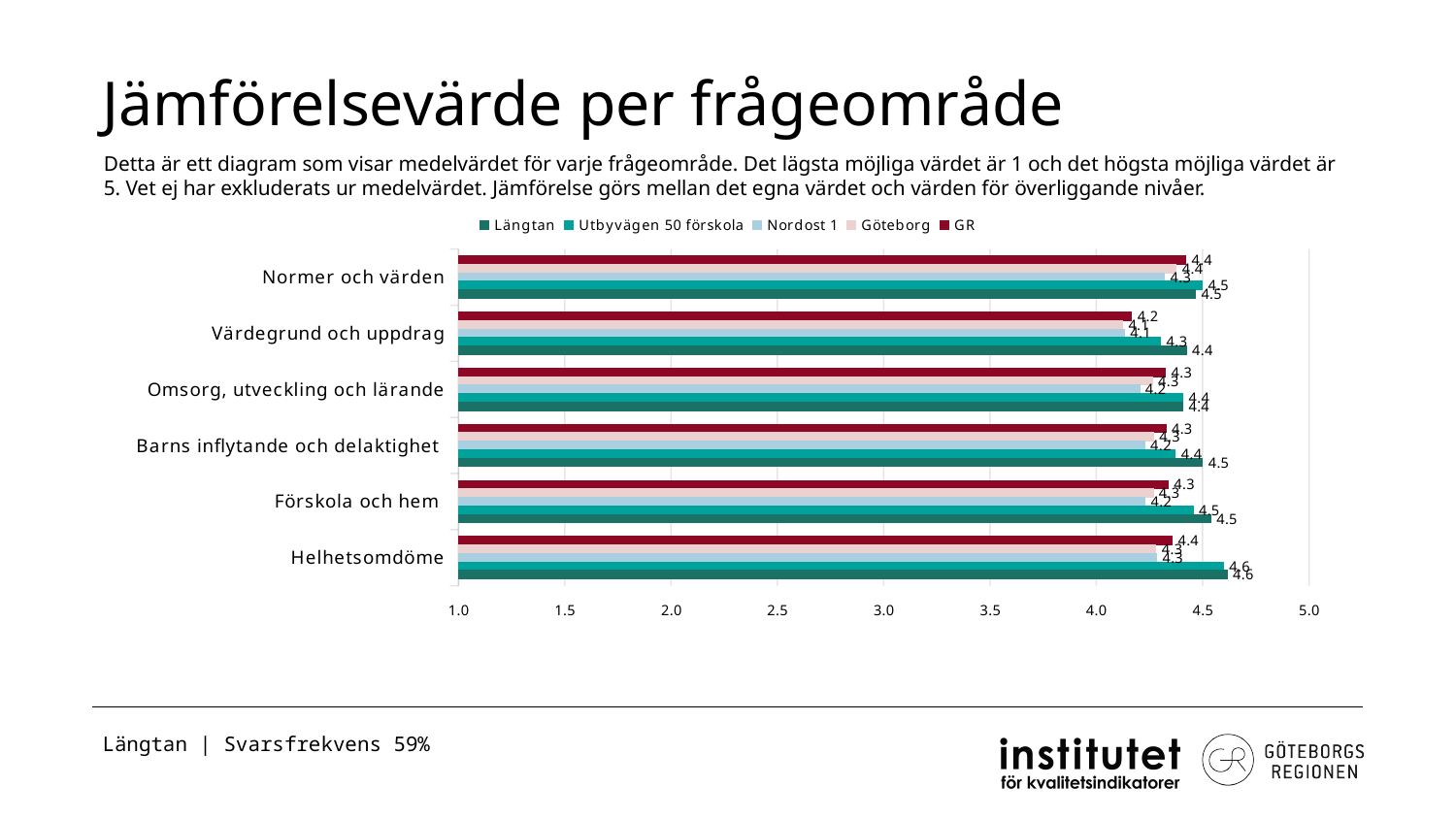
Which series is listed first in the legend? Längtan How many question areas (categories) are shown on the chart? 6 What kind of chart is shown on the slide? bar chart What is the value for Längtan in Helhetsomdöme? 4.6 What is the value for Längtan in Värdegrund och uppdrag? 4.4 What is the value for GR in Värdegrund och uppdrag? 4.2 What is the value for GR in Normer och värden? 4.4 What is the difference between the Längtan value and the GR value in Helhetsomdöme? 0.2 In which question area does Längtan have its highest value? Helhetsomdöme How many series does the legend list? 5 Is the value for Längtan in Värdegrund och uppdrag greater or less than 4.0? greater